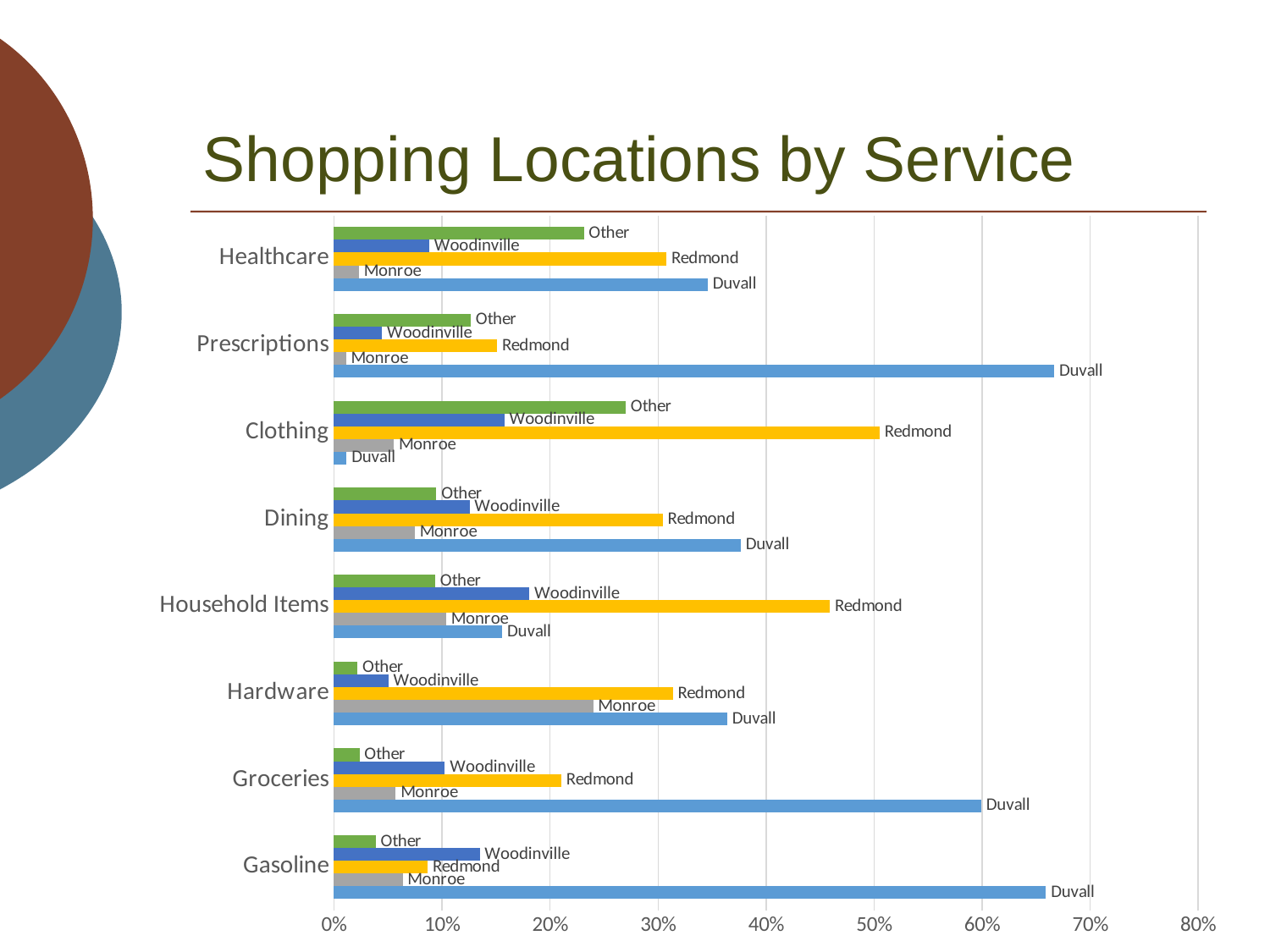
Under Gasoline, which is larger: Woodinville or Redmond? Woodinville Which location has the lowest value for Clothing? Duvall How many shopping locations are plotted for each service category? 5 Is the value for Duvall under Prescriptions greater or less than 60%? greater Is the value for Monroe under Hardware greater or less than 20%? greater How many service categories are plotted on the chart? 8 What kind of chart is shown on the slide? bar chart What is the title of the chart? Shopping Locations by Service Which location has the highest value for Clothing? Redmond Which service category has the highest value for Redmond? Clothing Is the value for Redmond under Clothing greater or less than 40%? greater